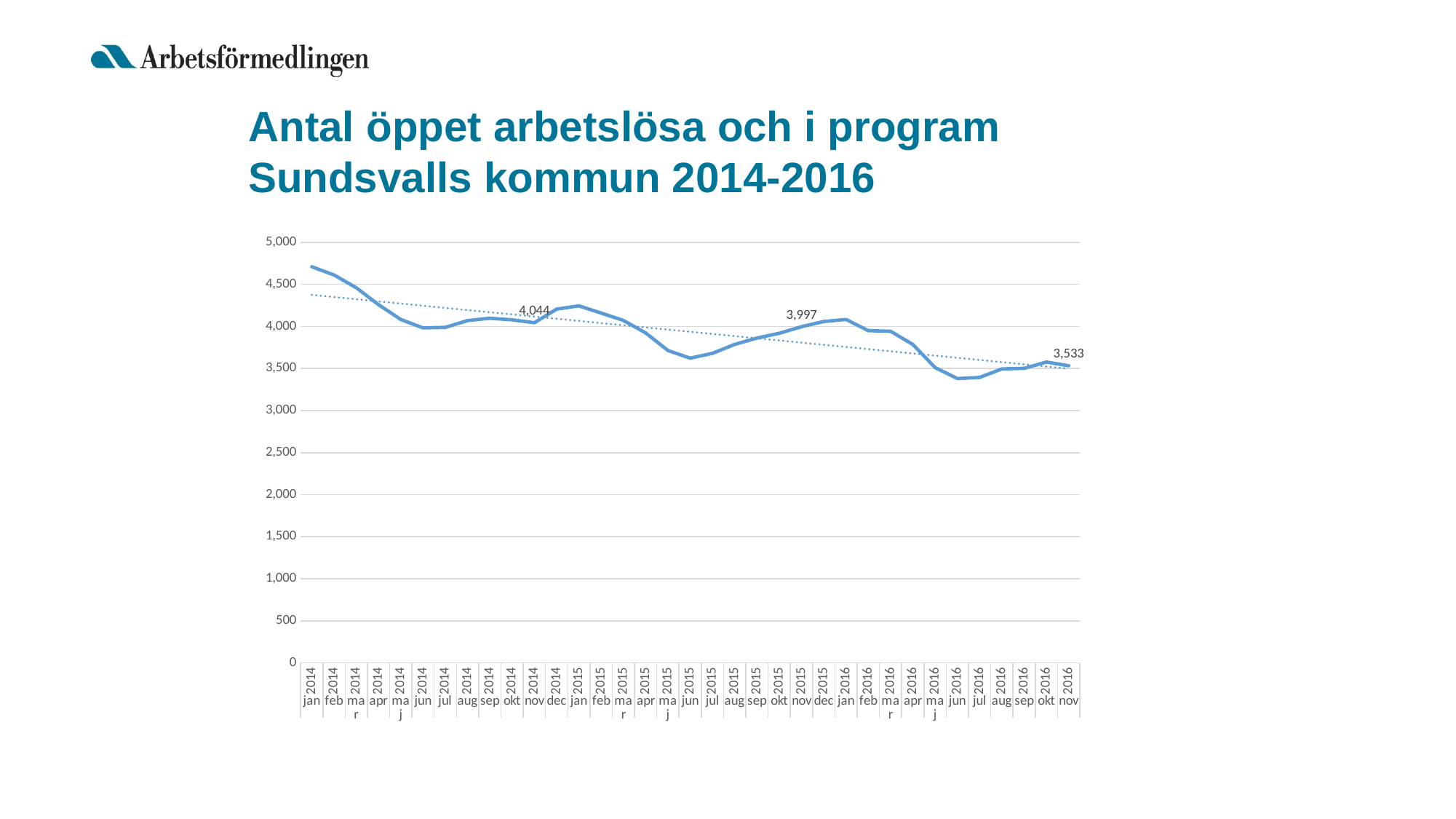
What kind of chart is shown on the slide? line chart What is the value for 2016 nov? 3,533 Is the value for 2014 jan greater or less than 4,500? greater Which month has the highest value on the chart? 2014 jan What is the difference between the values for 2015 nov and 2016 nov? 464 Do the values generally rise or fall from 2014 jan to 2016 nov? fall What is the difference between the values for 2014 nov and 2016 nov? 511 Which is larger, the value for 2014 nov or the value for 2016 nov? 2014 nov Is the value for 2016 jun greater or less than 3,500? less What is the value for 2014 nov? 4,044 What is the value for 2015 nov? 3,997 How many monthly data points are plotted on the chart? 35